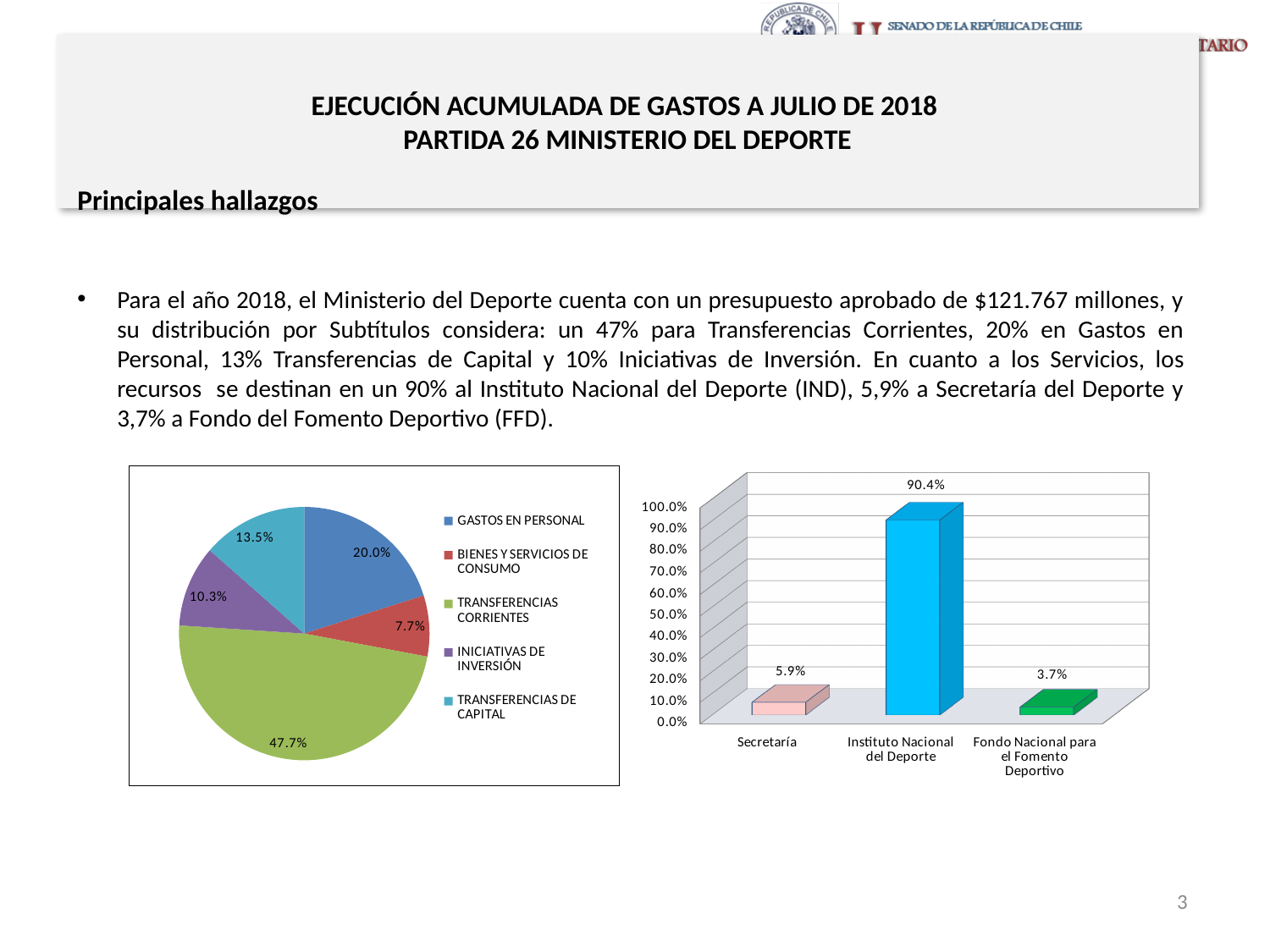
What type of chart is shown on the right side of the slide? Bar chart In the pie chart on the left, which is larger: INICIATIVAS DE INVERSIÓN or BIENES Y SERVICIOS DE CONSUMO? INICIATIVAS DE INVERSIÓN In the pie chart on the left, which category has the smallest slice? BIENES Y SERVICIOS DE CONSUMO In the pie chart on the left, which category has the largest slice? TRANSFERENCIAS CORRIENTES In the pie chart on the left, what is the difference between the shares of TRANSFERENCIAS DE CAPITAL and INICIATIVAS DE INVERSIÓN? 3.2% In the bar chart on the right, what is the difference between Secretaría and Fondo Nacional para el Fomento Deportivo? 2.2% In the pie chart on the left, how many categories does the legend list? 5 In the bar chart on the right, which category has the lowest value? Fondo Nacional para el Fomento Deportivo In the bar chart on the right, what is the value for Secretaría? 5.9% In the pie chart on the left, what share does TRANSFERENCIAS CORRIENTES have? 47.7% In the bar chart on the right, what is the value for Instituto Nacional del Deporte? 90.4% In the pie chart on the left, what share does GASTOS EN PERSONAL have? 20.0%